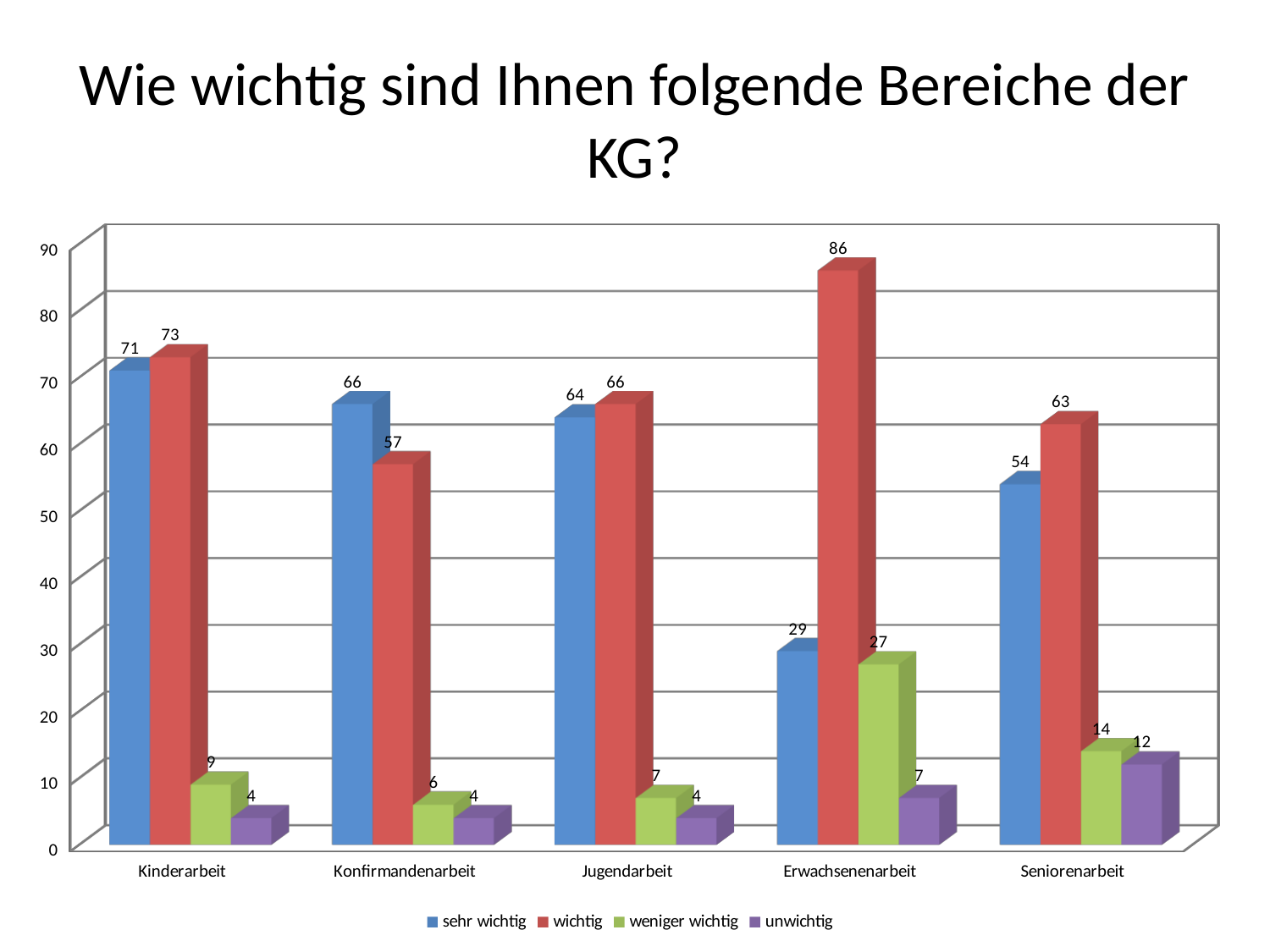
Which category has the lowest value for "sehr wichtig"? Erwachsenenarbeit How many categories are shown on the x axis? 5 Which is larger for Konfirmandenarbeit: "sehr wichtig" or "wichtig"? sehr wichtig Which category has the highest value for "sehr wichtig"? Kinderarbeit What is the value for "wichtig" in the Erwachsenenarbeit category? 86 What is the title of the chart? Wie wichtig sind Ihnen folgende Bereiche der KG? What is the value for "weniger wichtig" in the Kinderarbeit category? 9 What kind of chart is shown on the slide? Bar chart What is the value for "unwichtig" in the Seniorenarbeit category? 12 What is the difference between the "wichtig" and "sehr wichtig" values for Erwachsenenarbeit? 57 How many series does the legend list? 4 What is the value for "sehr wichtig" in the Seniorenarbeit category? 54